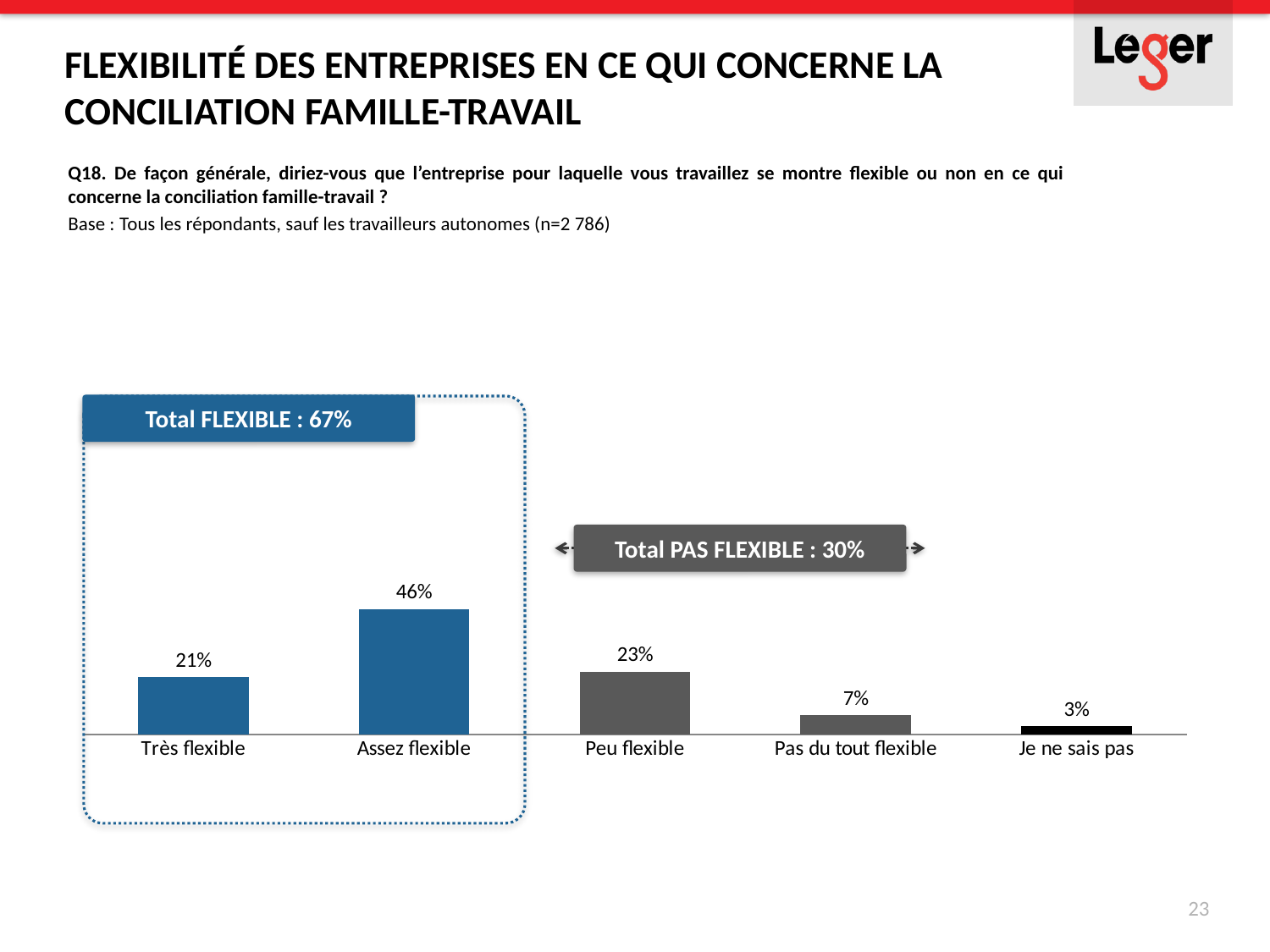
What is the value for Très flexible? 21% What is the value for Je ne sais pas? 3% Which category has the highest value? Assez flexible How many categories are shown on the chart? 5 Which category has the lowest value? Je ne sais pas What is the value for Pas du tout flexible? 7% What is the value for Peu flexible? 23% What kind of chart is shown on the slide? Bar chart Which is larger, the value for Très flexible or the value for Peu flexible? Peu flexible What is the value for Assez flexible? 46% What is the difference between the values for Assez flexible and Peu flexible? 23% What total is shown in the box labelled Total PAS FLEXIBLE? 30%